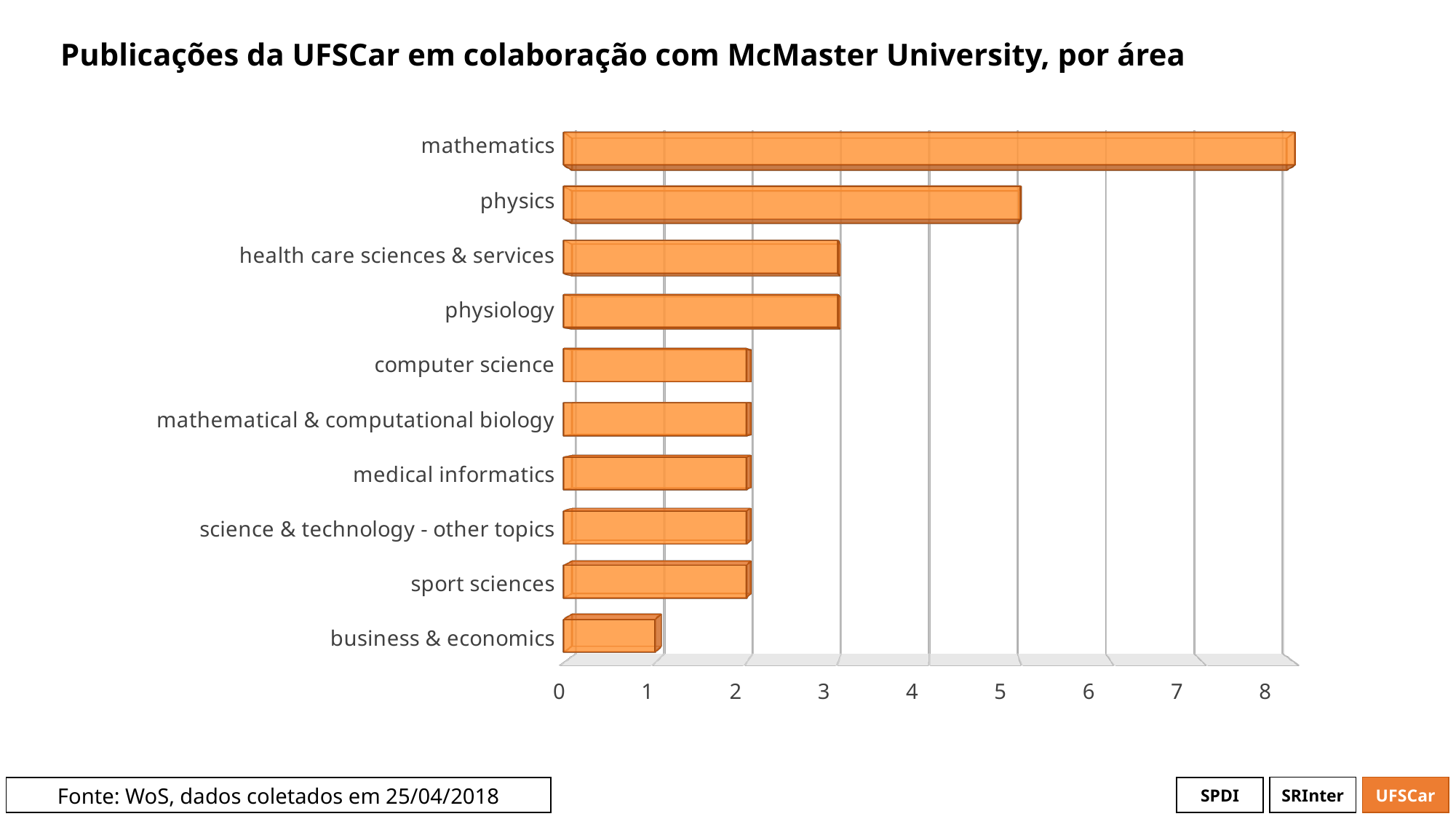
What type of chart is shown on the slide? bar chart Which has more publications, physics or physiology? physics How many areas (categories) are shown in the chart? 10 Which area has the lowest number of publications? business & economics Is the value for mathematics greater or less than 7? greater What is the title of the chart? Publicações da UFSCar em colaboração com McMaster University, por área How many publications are shown for sport sciences? 2 Which area has the highest number of publications? mathematics How many publications are shown for physics? 5 Which has more publications, health care sciences & services or computer science? health care sciences & services Is the value for physics greater or less than 4? greater Is the value for business & economics greater or less than 2? less